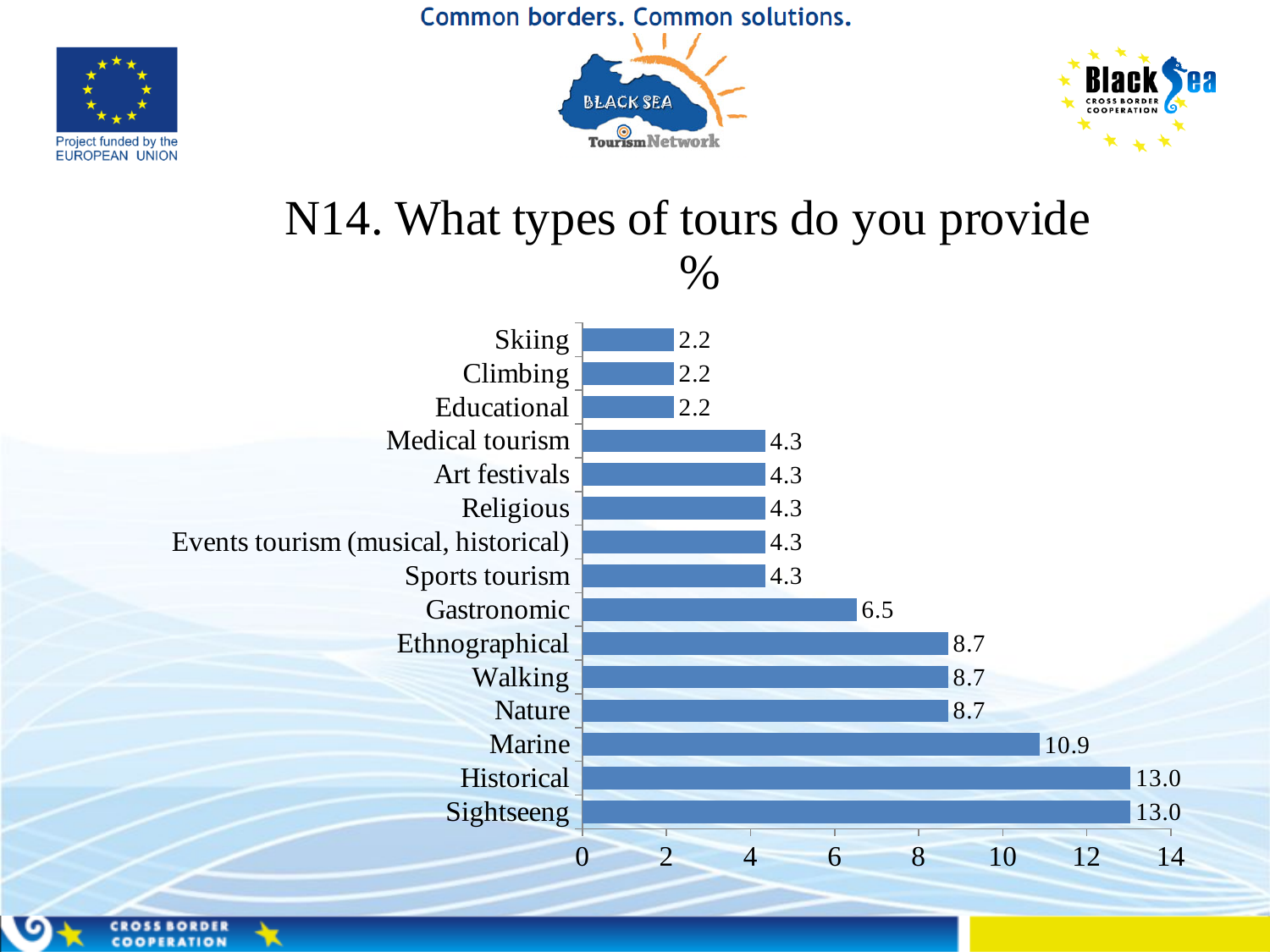
Is the value for Marine greater or less than 10? greater What is the value for Skiing? 2.2 What is the difference between the values for Marine and Gastronomic? 4.4 What is the smallest value shown on the chart? 2.2 What is the largest value shown on the chart? 13.0 What kind of chart is shown on the slide? bar chart What is the difference between the values for Historical and Nature? 4.3 What is the value for Gastronomic? 6.5 How many categories are shown on the chart? 15 What is the value for Marine? 10.9 Which is larger, the value for Marine or the value for Ethnographical? Marine What is the value for Medical tourism? 4.3